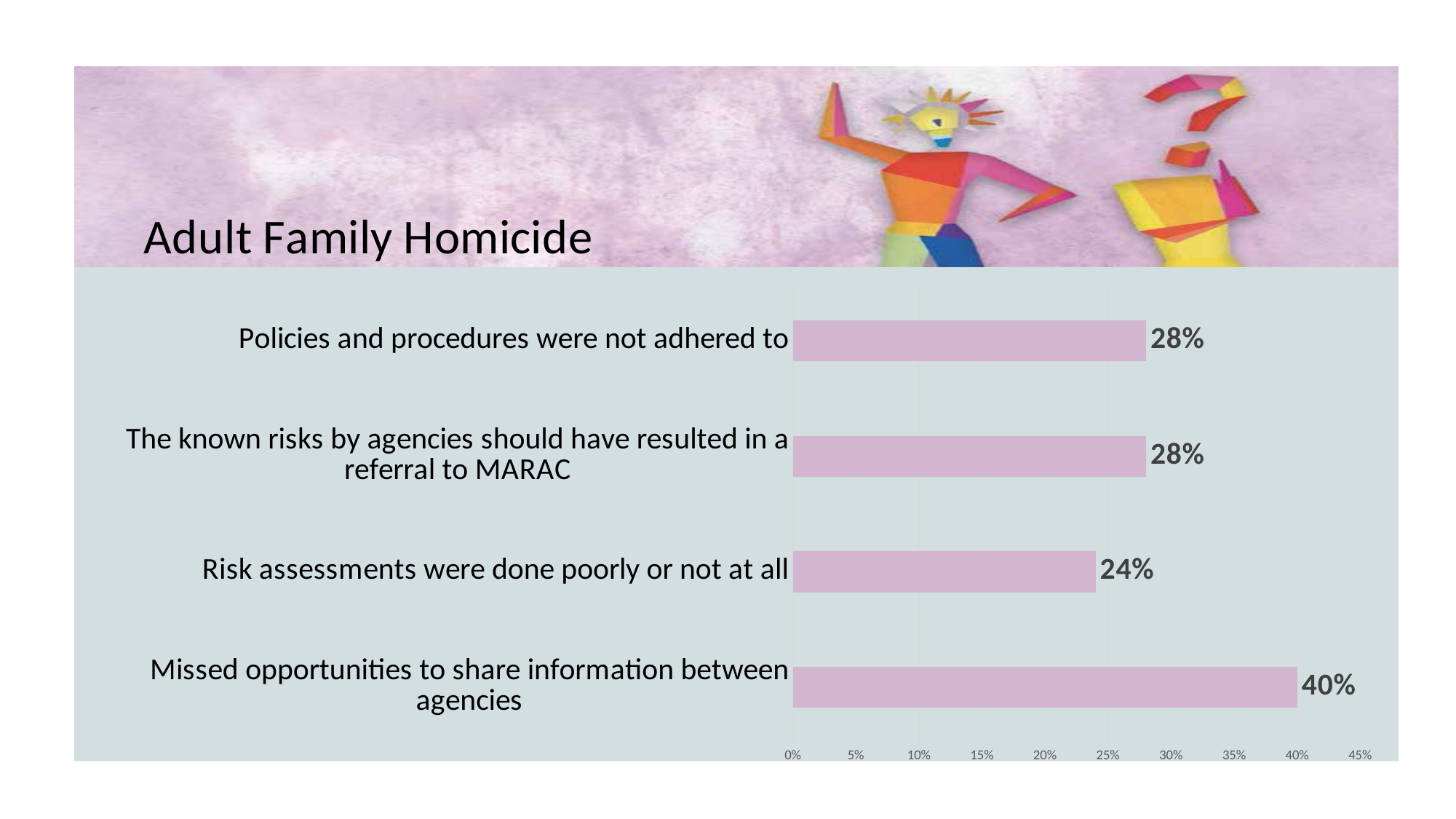
What is the value for 'Risk assessments were done poorly or not at all'? 24% What is the value for 'Missed opportunities to share information between agencies'? 40% Which category has the lowest value? Risk assessments were done poorly or not at all Which is larger: the value for 'Policies and procedures were not adhered to' or the value for 'Risk assessments were done poorly or not at all'? Policies and procedures were not adhered to What kind of chart is shown on the slide? Bar chart Is the value for 'Missed opportunities to share information between agencies' greater or less than 35%? greater What is the value for 'The known risks by agencies should have resulted in a referral to MARAC'? 28% What is the value for 'Policies and procedures were not adhered to'? 28% How many categories are shown in the chart? 4 What is the difference between the value for 'Missed opportunities to share information between agencies' and the value for 'Risk assessments were done poorly or not at all'? 16% What is the title of the slide containing the chart? Adult Family Homicide Which category has the highest value? Missed opportunities to share information between agencies